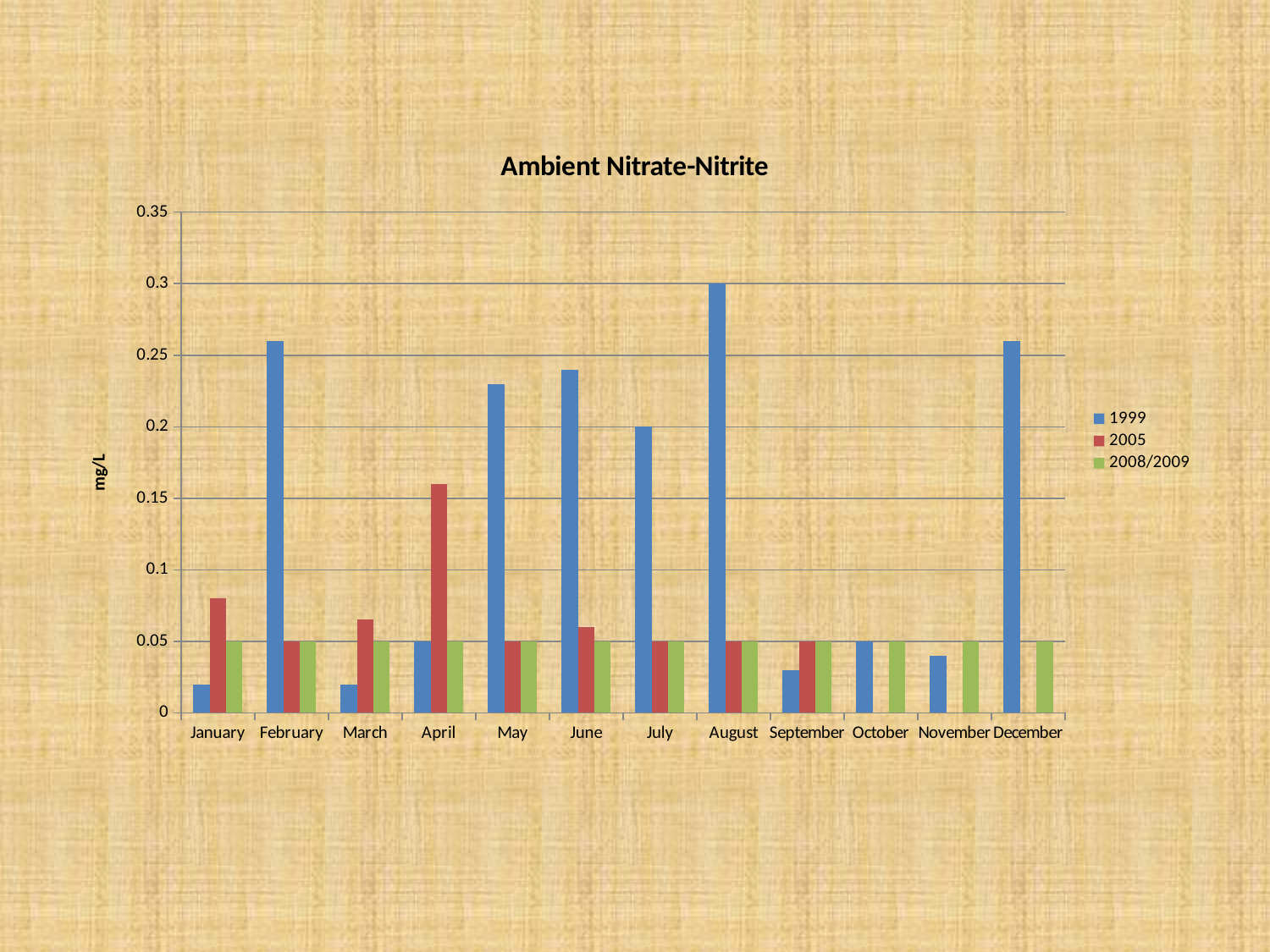
In which month is the 2005 value highest? April What is the label on the y axis? mg/L What is the 1999 value for August, in mg/L? 0.3 For the 1999 series, which month has the larger value, July or December? December Is the 2005 value for April greater or less than 0.1? greater How many months are shown on the x axis? 12 In January, which series has the larger value, 1999 or 2005? 2005 In which month is the 1999 value highest? August What kind of chart is shown on the slide? bar chart Is the 1999 value for February greater or less than 0.2? greater What is the 2008/2009 value for January, in mg/L? 0.05 How many series does the legend list? 3